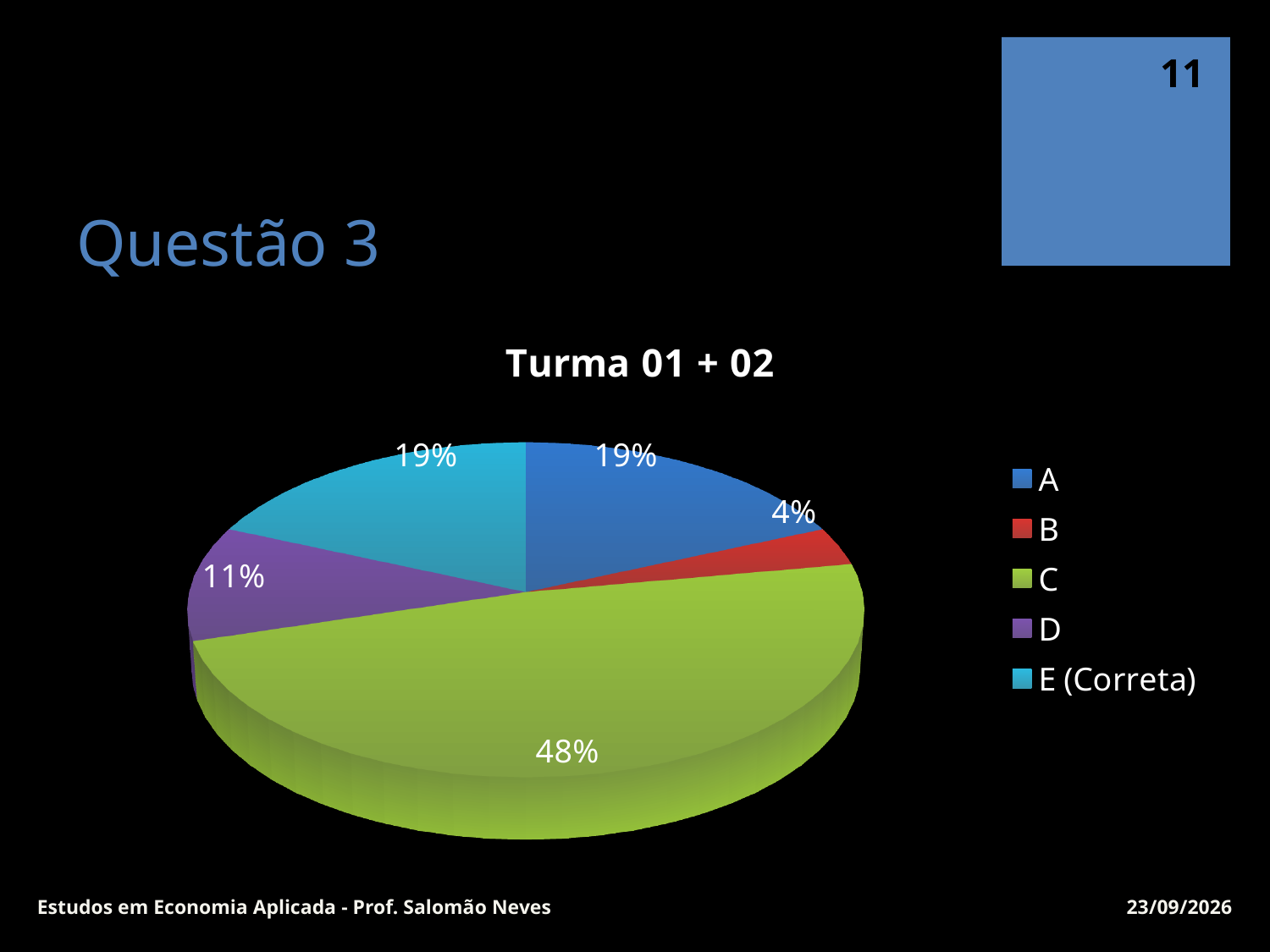
What is the difference in percentage points between category C and category D? 37 How many categories does the legend list? 5 Which category has the smallest slice of the pie? B Which is larger, the slice for A or the slice for D? A Which category has the largest slice of the pie? C What share of the pie does category D have? 11% What type of chart is shown on the slide? pie chart What is the title of the chart? Turma 01 + 02 What share of the pie does category E (Correta) have? 19% What share of the pie does category B have? 4% Which legend entry is marked as the correct answer? E (Correta)